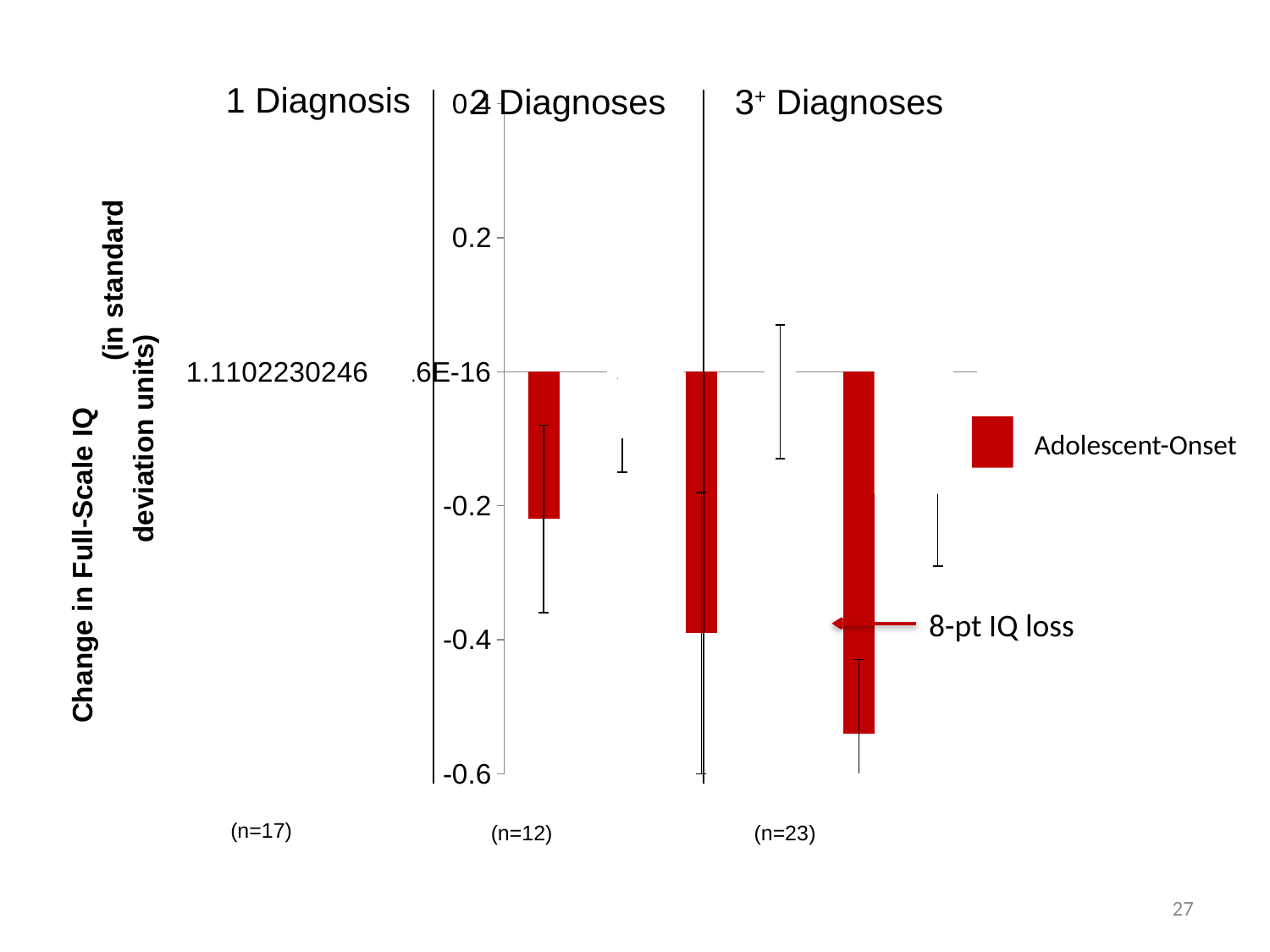
Which is larger, the value for 1 Diagnosis or the value for 3+ Diagnoses? 1 Diagnosis Is the value for 3+ Diagnoses greater or less than -0.4? less How many diagnosis categories are plotted as bars? 3 Is the value for 2 Diagnoses greater or less than -0.2? less How many series does the legend list? 1 Do the values rise or fall moving from 1 Diagnosis to 3+ Diagnoses along the x axis? fall Which category has the lowest (most negative) change in Full-Scale IQ? 3+ Diagnoses What is the sample size shown for the 3+ Diagnoses group? n=23 What kind of chart is shown on the slide? bar chart What series name appears in the legend? Adolescent-Onset Which category has the highest (least negative) change in Full-Scale IQ? 1 Diagnosis Is the value for 1 Diagnosis greater or less than -0.4? greater